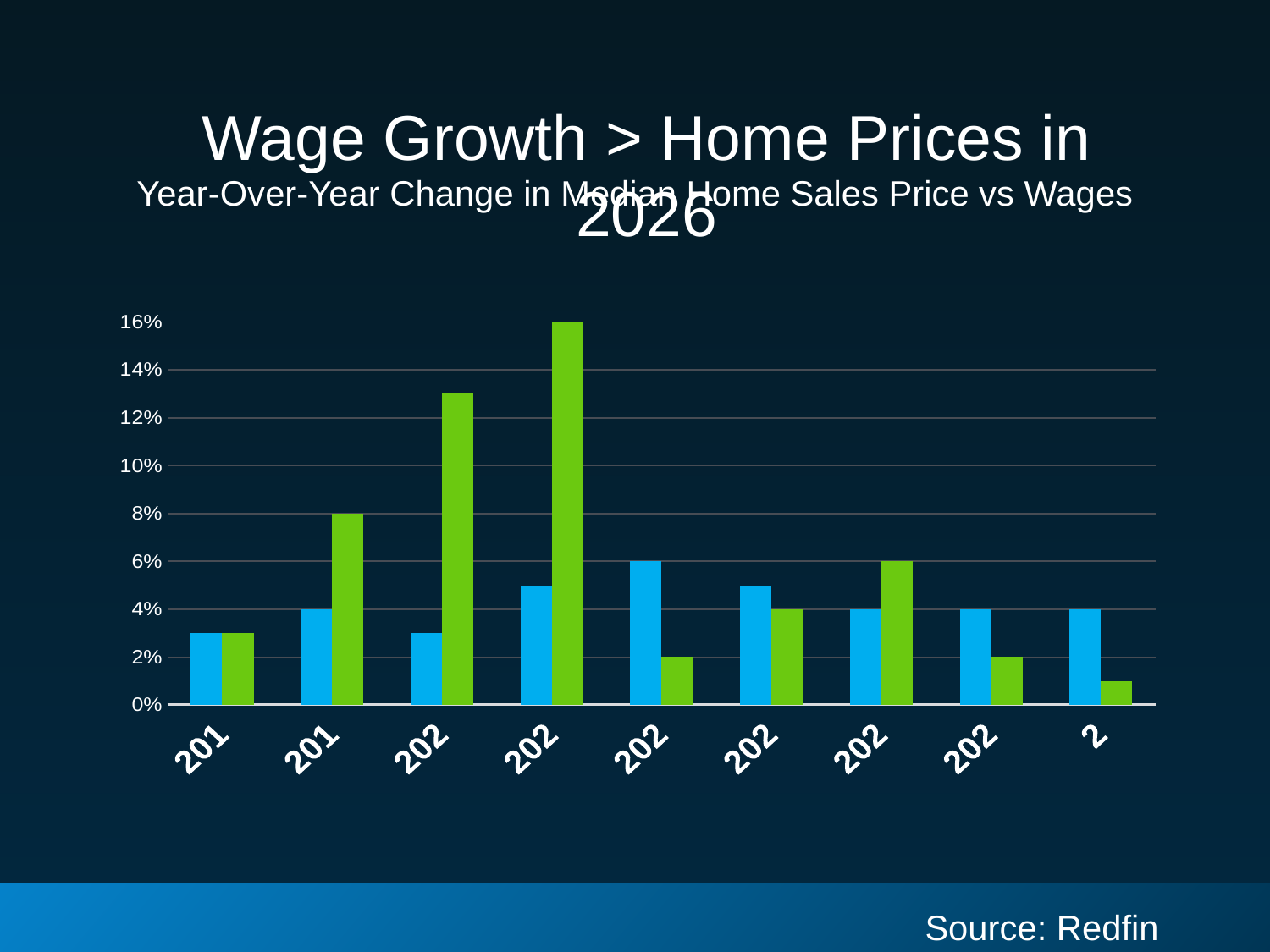
What source is cited for the chart? Redfin Is the green bar in the last group on the right greater or less than 2%? less What is the highest value shown on the y axis? 16% Is the green bar in the third group from the left greater or less than 12%? greater How many bar colours (series) are plotted in the chart? 2 How many groups of bars are plotted along the x axis? 9 What kind of chart is shown on the slide? bar chart What is the value of the green bar in the fourth group from the left? 16% What is the value of the blue bar in the fifth group from the left? 6% What is the value of the tallest bar in the chart? 16% In the fifth group from the left, which bar is taller, the blue one or the green one? the blue one What is the value of the green bar in the second group from the left? 8%